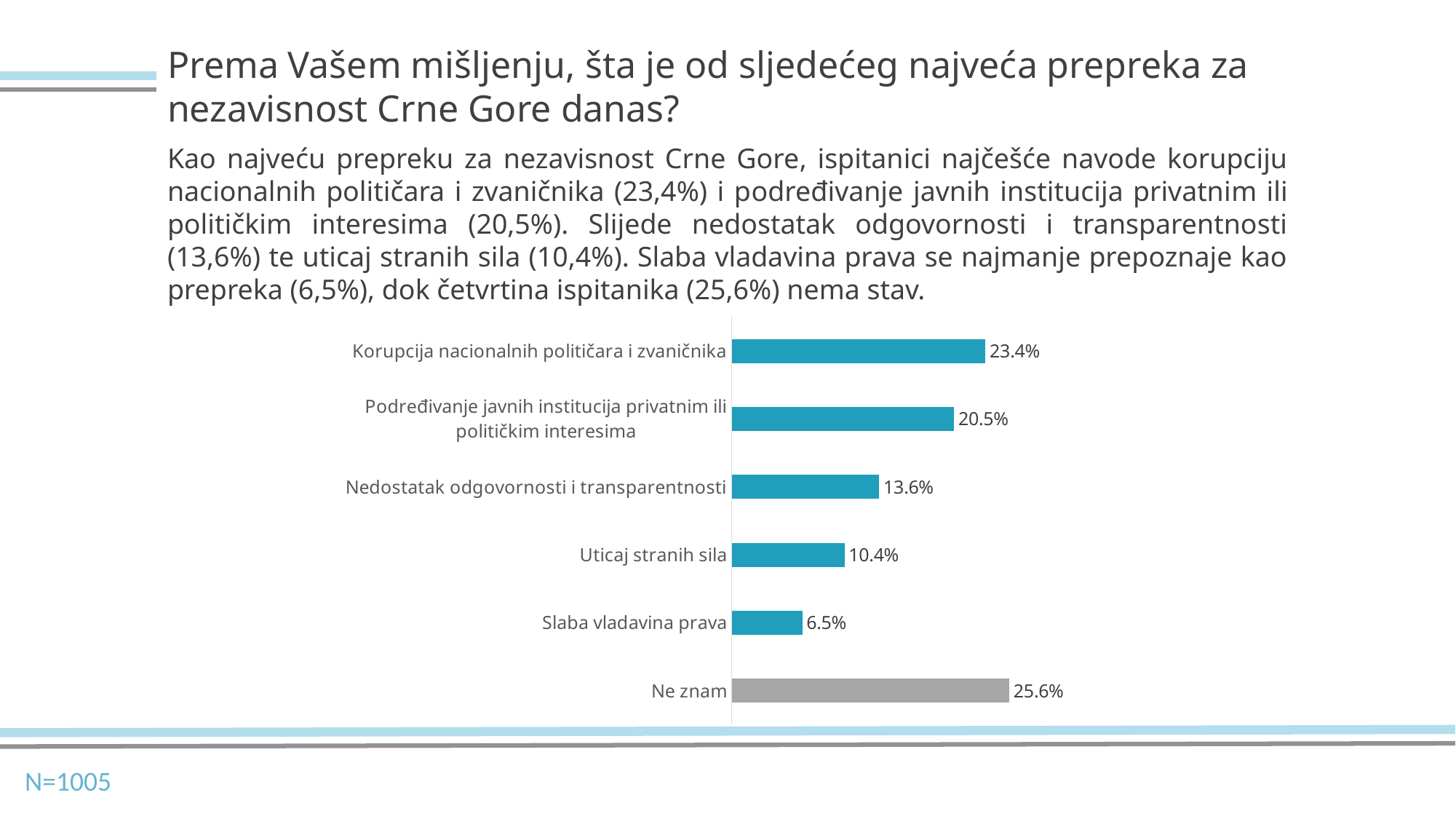
What is the value for "Slaba vladavina prava"? 6.5% What is the difference between the values for "Korupcija nacionalnih političara i zvaničnika" and "Podređivanje javnih institucija privatnim ili političkim interesima"? 2.9% What is the value for "Korupcija nacionalnih političara i zvaničnika"? 23.4% Which category has the highest value in the chart? Ne znam What kind of chart is shown on the slide? Bar chart Which category has the lowest value in the chart? Slaba vladavina prava How many categories are shown in the chart? 6 What is the difference between the values for "Ne znam" and "Slaba vladavina prava"? 19.1% What is the value for "Ne znam"? 25.6% Which is larger: the value for "Nedostatak odgovornosti i transparentnosti" or the value for "Uticaj stranih sila"? Nedostatak odgovornosti i transparentnosti What is the value for "Uticaj stranih sila"? 10.4% Which bar in the chart is coloured grey rather than blue? Ne znam